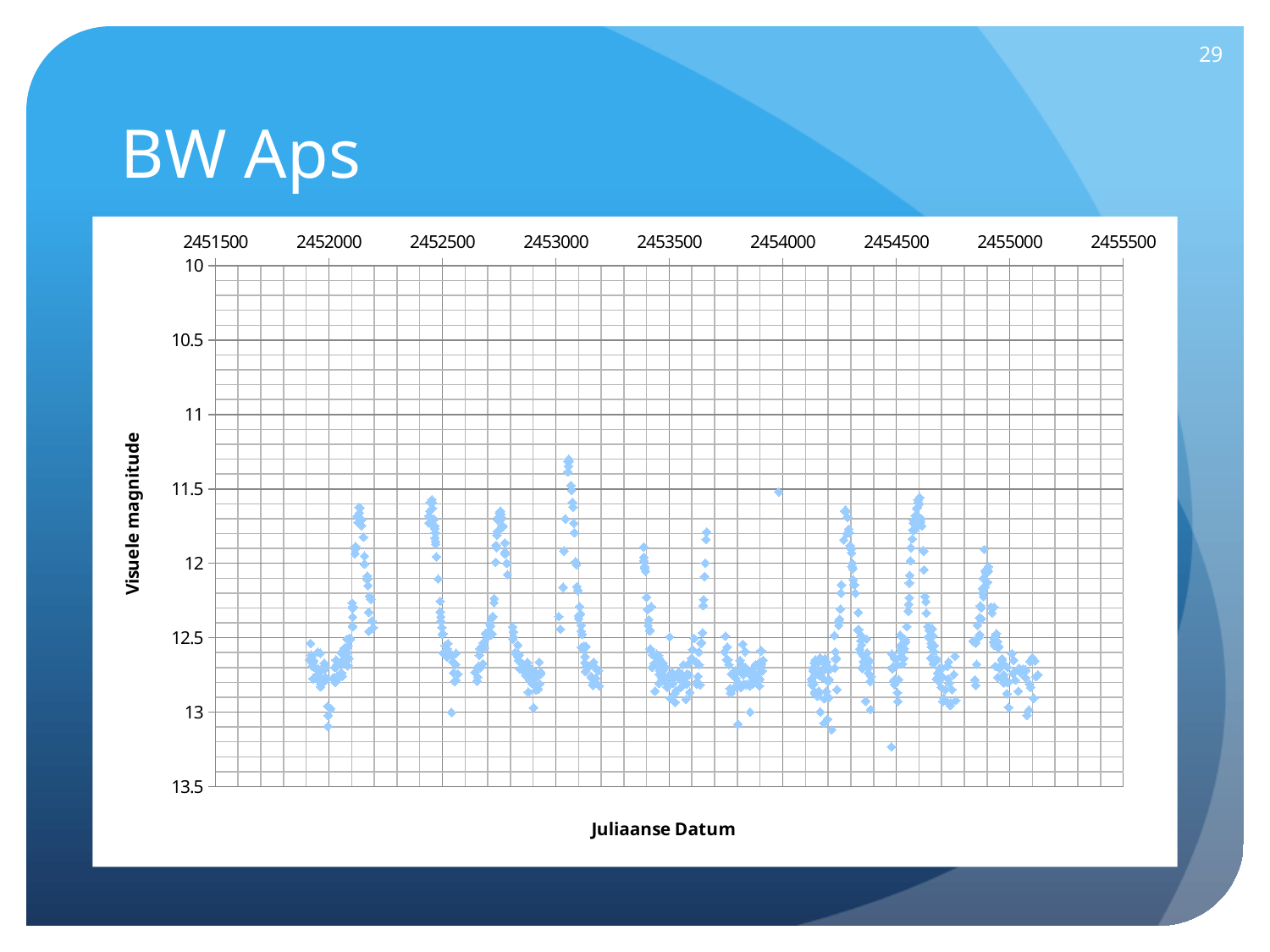
What is the label of the vertical axis of the chart? Visuele magnitude How many tick labels are shown on the horizontal axis of the chart? 9 What kind of chart is shown on the slide? scatter chart What is the highest value shown on the vertical axis of the chart? 13.5 What is the spacing between consecutive tick labels on the vertical axis of the chart? 0.5 What is the label of the horizontal axis of the chart? Juliaanse Datum What is the lowest value shown on the vertical axis of the chart? 10 Is the smallest magnitude value plotted (the highest point, near Julian date 2453000) greater or less than 11.5? less What is the first tick value shown on the horizontal axis of the chart? 2451500 What is the last tick value shown on the horizontal axis of the chart? 2455500 What is the title of the slide containing the chart? BW Aps Is the largest magnitude value plotted (the lowest point, near Julian date 2454500) greater or less than 13? greater